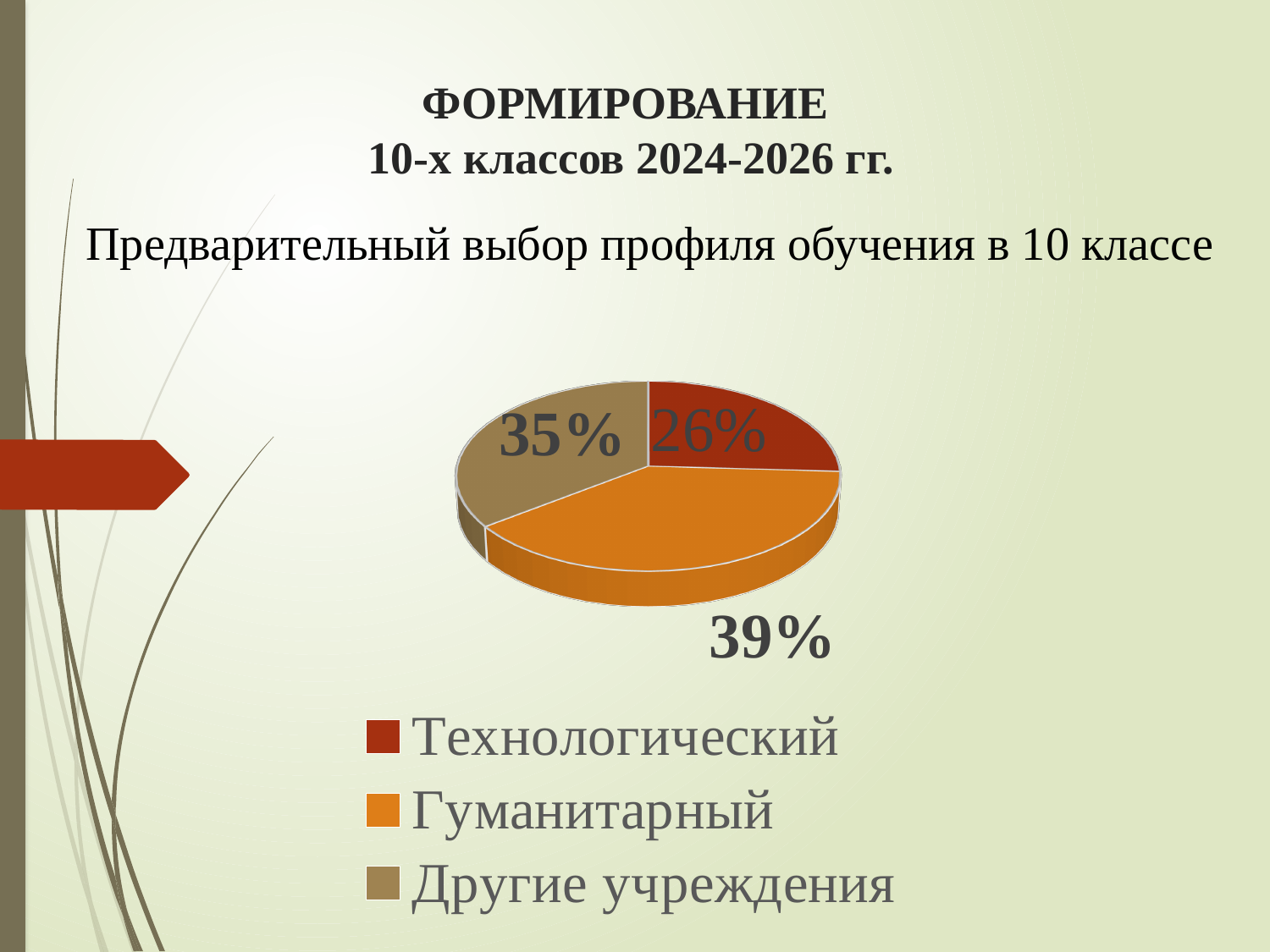
What is the difference in percentage points between Другие учреждения and Технологический? 9 How many categories does the pie chart have? 3 What share of the pie does Гуманитарный have? 39% Which is larger, the slice for Гуманитарный or the slice for Другие учреждения? Гуманитарный Which category has the smallest slice of the pie? Технологический What share of the pie does Другие учреждения have? 35% What kind of chart is shown on the slide? pie chart Which category has the largest slice of the pie? Гуманитарный What is the difference in percentage points between Гуманитарный and Технологический? 13 What share of the pie does Технологический have? 26% What colour is the slice for Гуманитарный? orange Which legend entry is listed first? Технологический